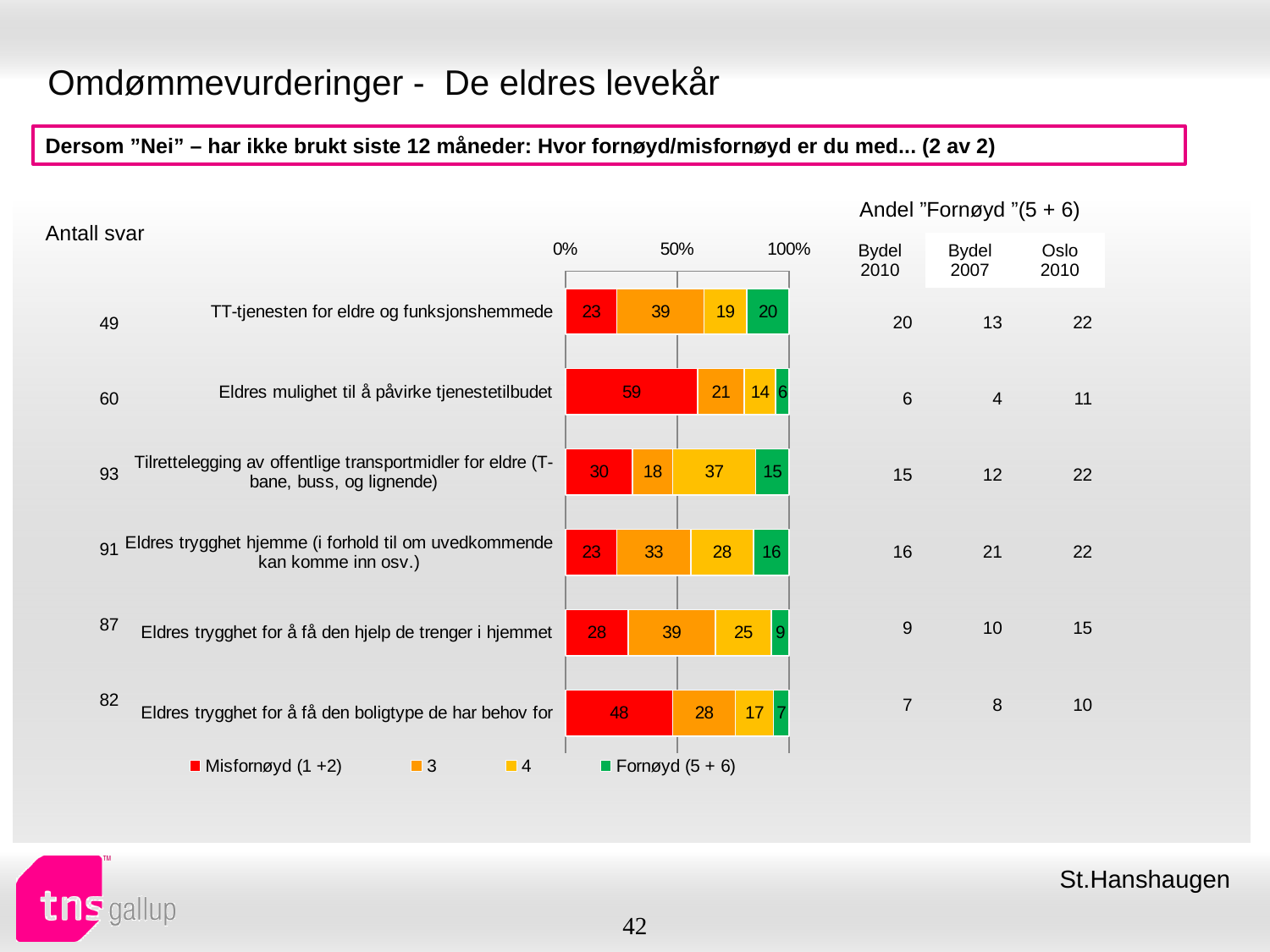
Which colour represents Fornøyd (5 + 6) in the chart? Green Which category has the lowest Fornøyd (5 + 6) value? Eldres mulighet til å påvirke tjenestetilbudet Which is larger: the Fornøyd (5 + 6) value for 'Eldres trygghet hjemme (i forhold til om uvedkommende kan komme inn osv.)' or for 'Eldres trygghet for å få den hjelp de trenger i hjemmet'? Eldres trygghet hjemme (i forhold til om uvedkommende kan komme inn osv.) What is the total of the stacked bar for 'Eldres mulighet til å påvirke tjenestetilbudet'? 100 What is the difference between the Misfornøyd (1 +2) values for 'Eldres trygghet for å få den boligtype de har behov for' and 'Eldres trygghet for å få den hjelp de trenger i hjemmet'? 20 What kind of chart is shown on the slide? Stacked bar chart How many series does the legend list? 4 What is the Misfornøyd (1 +2) value for 'Eldres mulighet til å påvirke tjenestetilbudet'? 59 Which category has the highest Misfornøyd (1 +2) value? Eldres mulighet til å påvirke tjenestetilbudet What is the Fornøyd (5 + 6) value for 'TT-tjenesten for eldre og funksjonshemmede'? 20 How many categories are shown in the chart? 6 What is the value of series '4' for 'Tilrettelegging av offentlige transportmidler for eldre (T-bane, buss, og lignende)'? 37